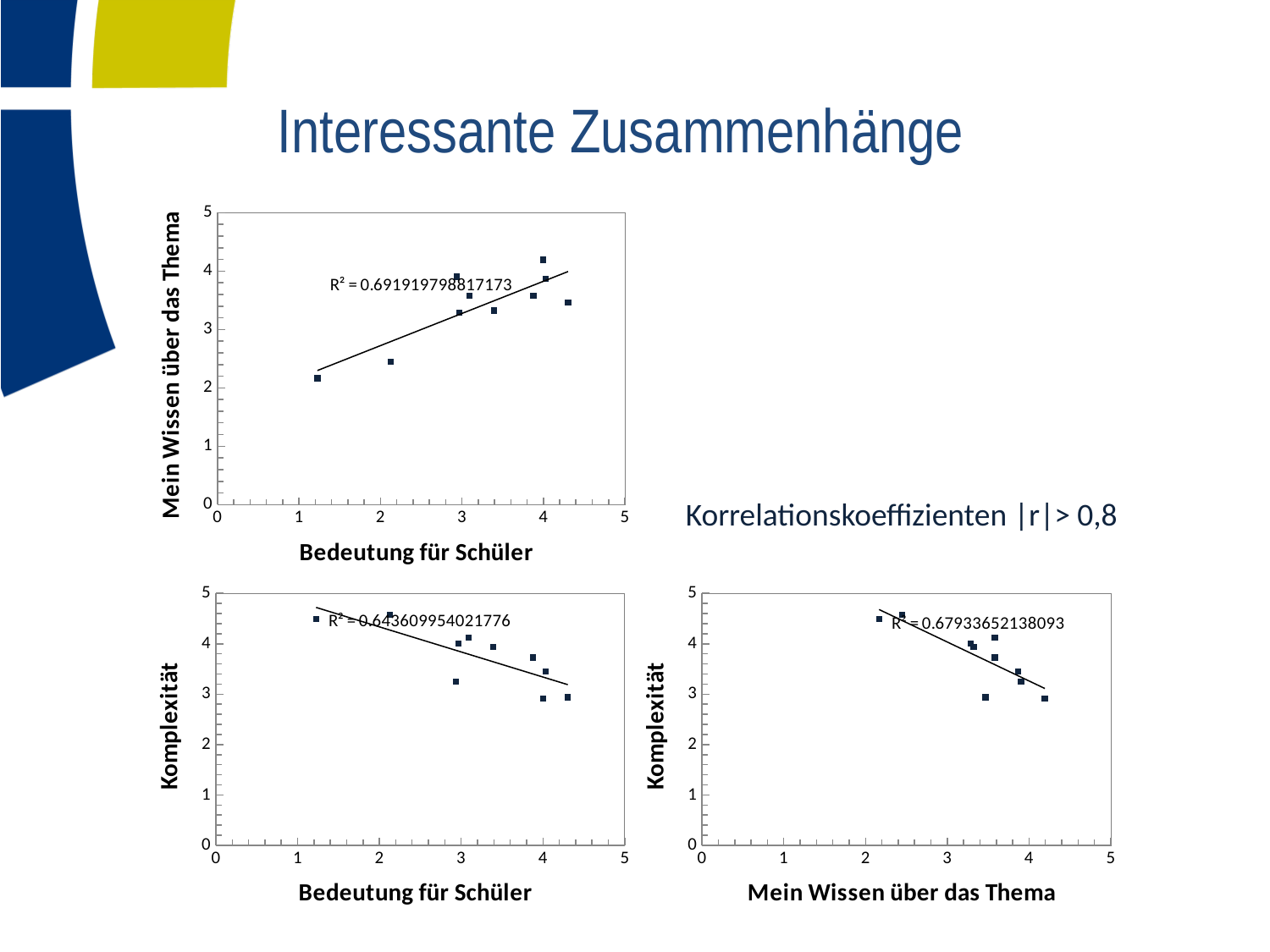
What kind of chart is the top-left chart on the slide? scatter chart What R² value is printed on the bottom-left chart? R² = 0.643609954021776 In the top-left chart, is the y-value of the leftmost point (at x of about 1.2) greater or less than 3? less What R² value is printed on the bottom-right chart? R² = 0.67933652138093 What is the y-axis label of the top-left chart? Mein Wissen über das Thema In the bottom-right chart (Mein Wissen über das Thema vs. Komplexität), do the points rise or fall as the x-axis value increases? fall What R² value is printed on the top-left chart? R² = 0.691919798817173 In the top-left chart (Bedeutung für Schüler vs. Mein Wissen über das Thema), do the points rise or fall as the x-axis value increases? rise In the bottom-left chart, is the y-value of the leftmost point (at x of about 1.2) greater or less than 4? greater What is the x-axis label of the bottom-right chart? Mein Wissen über das Thema In the bottom-left chart (Bedeutung für Schüler vs. Komplexität), do the points rise or fall as the x-axis value increases? fall In the bottom-right chart, is the y-value of the leftmost point (at x of about 2.2) greater or less than 4? greater